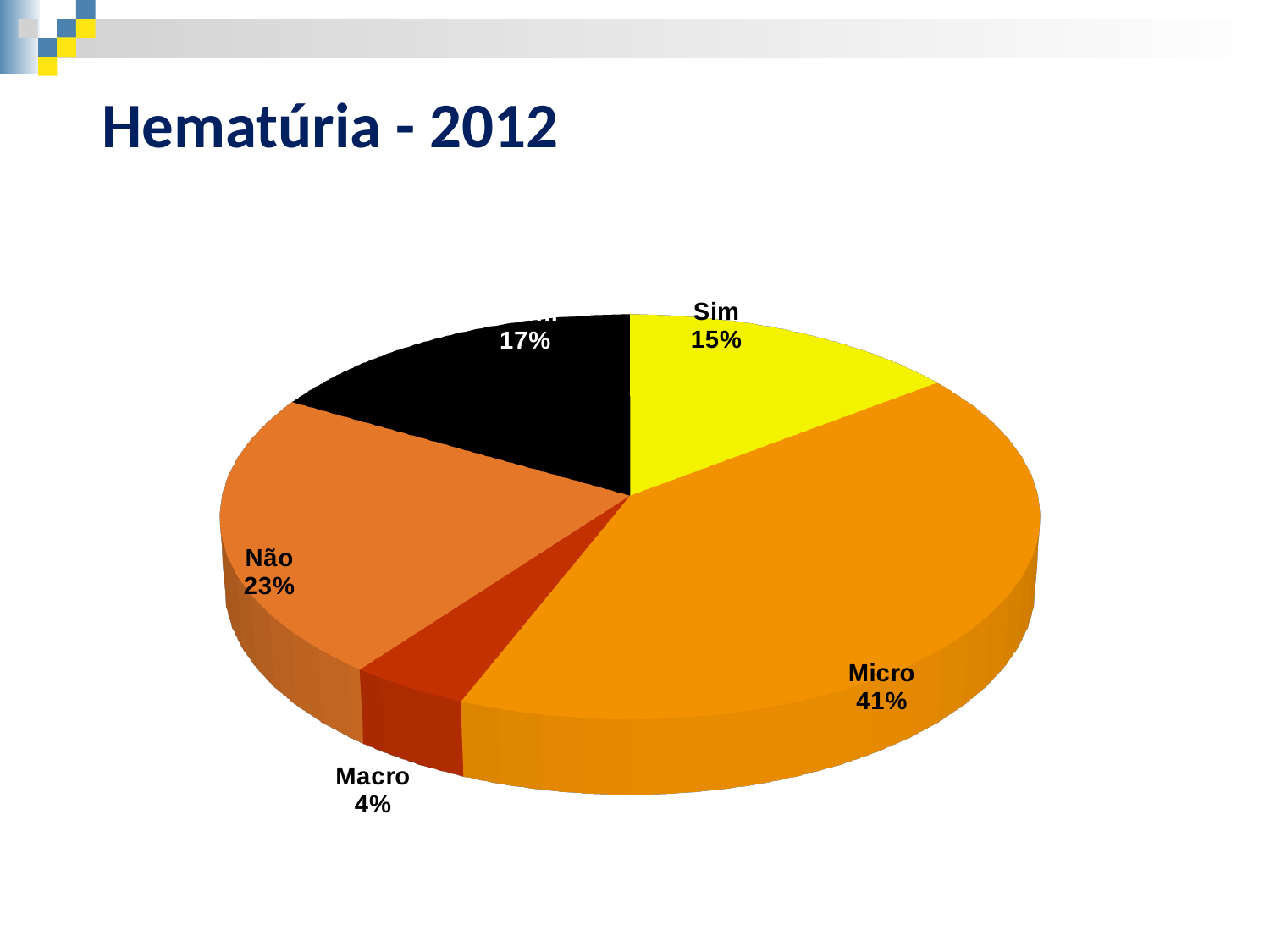
What is the title of the chart on the slide? Hematúria - 2012 What percentage does the Sim slice represent? 15% Which slice has the smallest share of the pie? Macro What type of chart is shown on the slide? pie chart What percentage does the Macro slice represent? 4% What percentage does the Não slice represent? 23% How many slices does the pie chart have? 5 What percentage does the Micro slice represent? 41% Which slice has the largest share of the pie? Micro Which is larger, the Não slice or the Sim slice? Não What colour is the Sim slice? yellow What is the difference in percentage points between the Micro and Não slices? 18